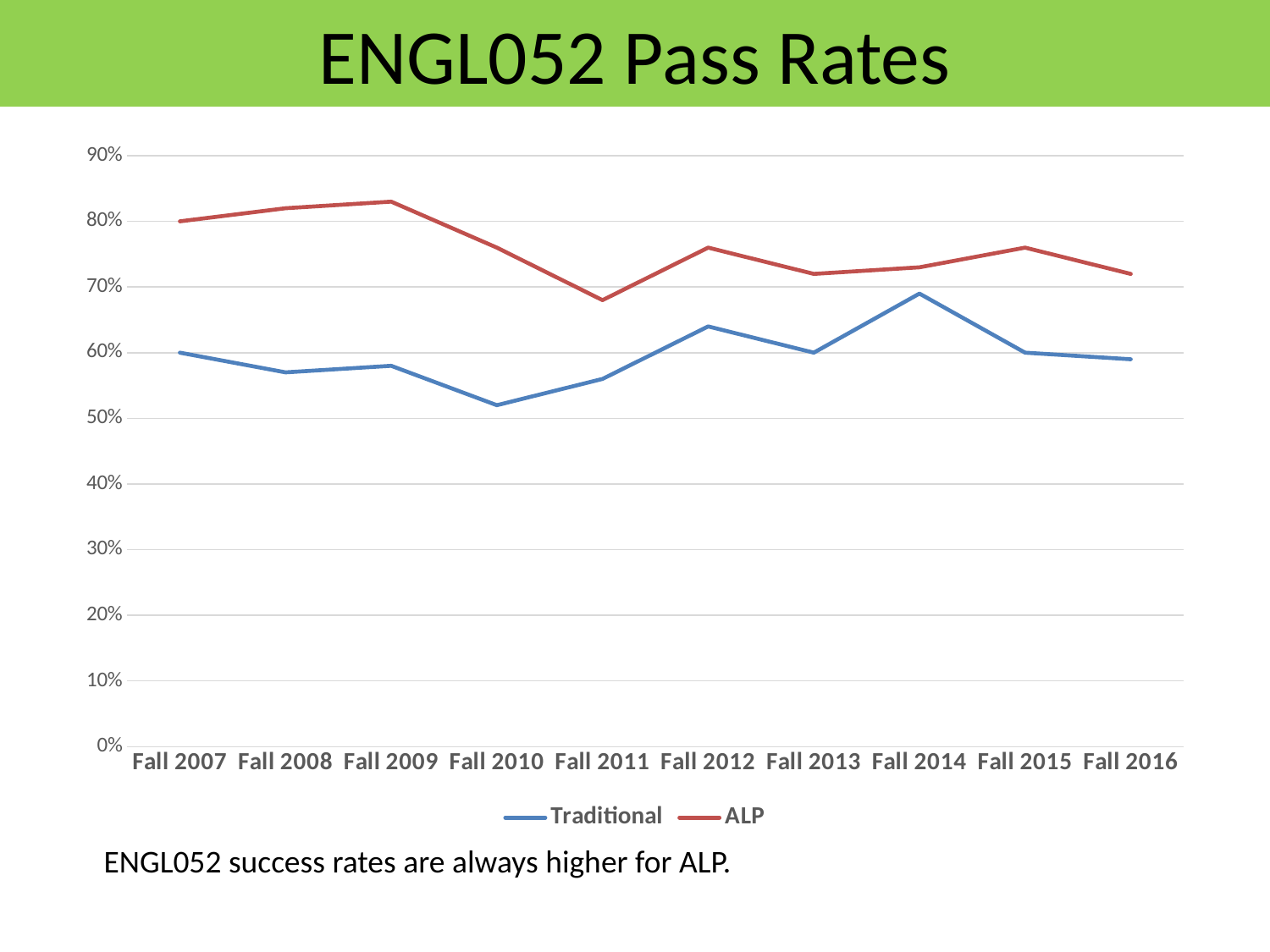
What is the Traditional pass rate for Fall 2007? 60% Is the ALP pass rate for Fall 2009 greater or less than 80%? greater What is the ALP pass rate for Fall 2007? 80% What kind of chart is shown on the slide? Line chart Is the Traditional pass rate for Fall 2010 greater or less than 60%? less In which semester is the Traditional pass rate highest? Fall 2014 Which series has the higher pass rate in Fall 2012, Traditional or ALP? ALP In which semester is the ALP pass rate highest? Fall 2009 How many series does the legend list? 2 How many semesters are plotted along the x axis? 10 In which semester is the ALP pass rate lowest? Fall 2011 In which semester is the Traditional pass rate lowest? Fall 2010